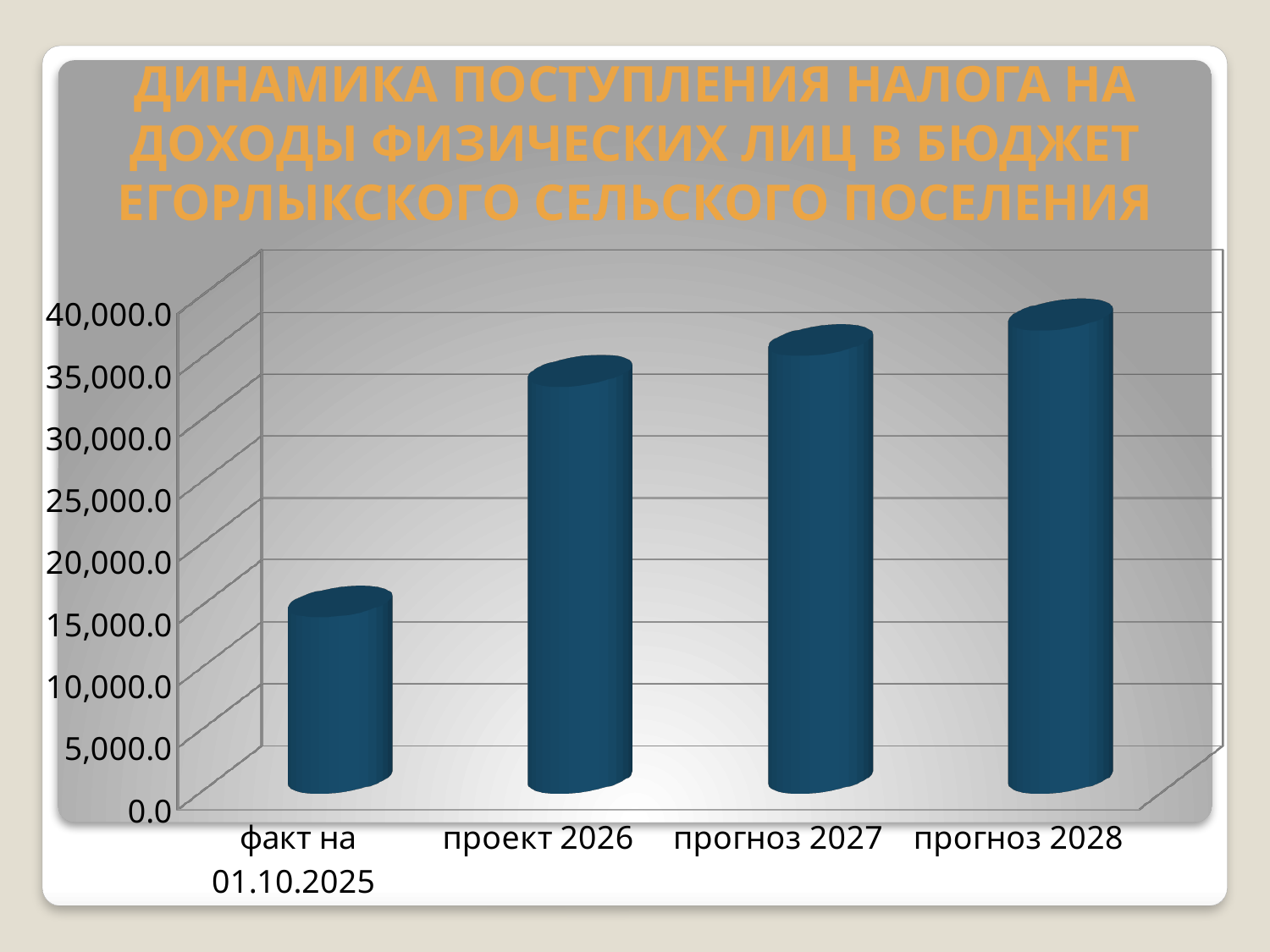
Do the values rise or fall from факт на 01.10.2025 to прогноз 2028? rise Is the value for факт на 01.10.2025 greater or less than 10,000.0? greater How many categories are shown on the x axis of the chart? 4 Which category has the lowest value in the chart? факт на 01.10.2025 What kind of chart is shown on the slide? bar chart Which category has the highest value in the chart? прогноз 2028 Is the value for факт на 01.10.2025 greater or less than 20,000.0? less Is the value for проект 2026 greater or less than 30,000.0? greater What is the title of the chart on the slide? ДИНАМИКА ПОСТУПЛЕНИЯ НАЛОГА НА ДОХОДЫ ФИЗИЧЕСКИХ ЛИЦ В БЮДЖЕТ ЕГОРЛЫКСКОГО СЕЛЬСКОГО ПОСЕЛЕНИЯ Which is larger: the value for проект 2026 or the value for факт на 01.10.2025? проект 2026